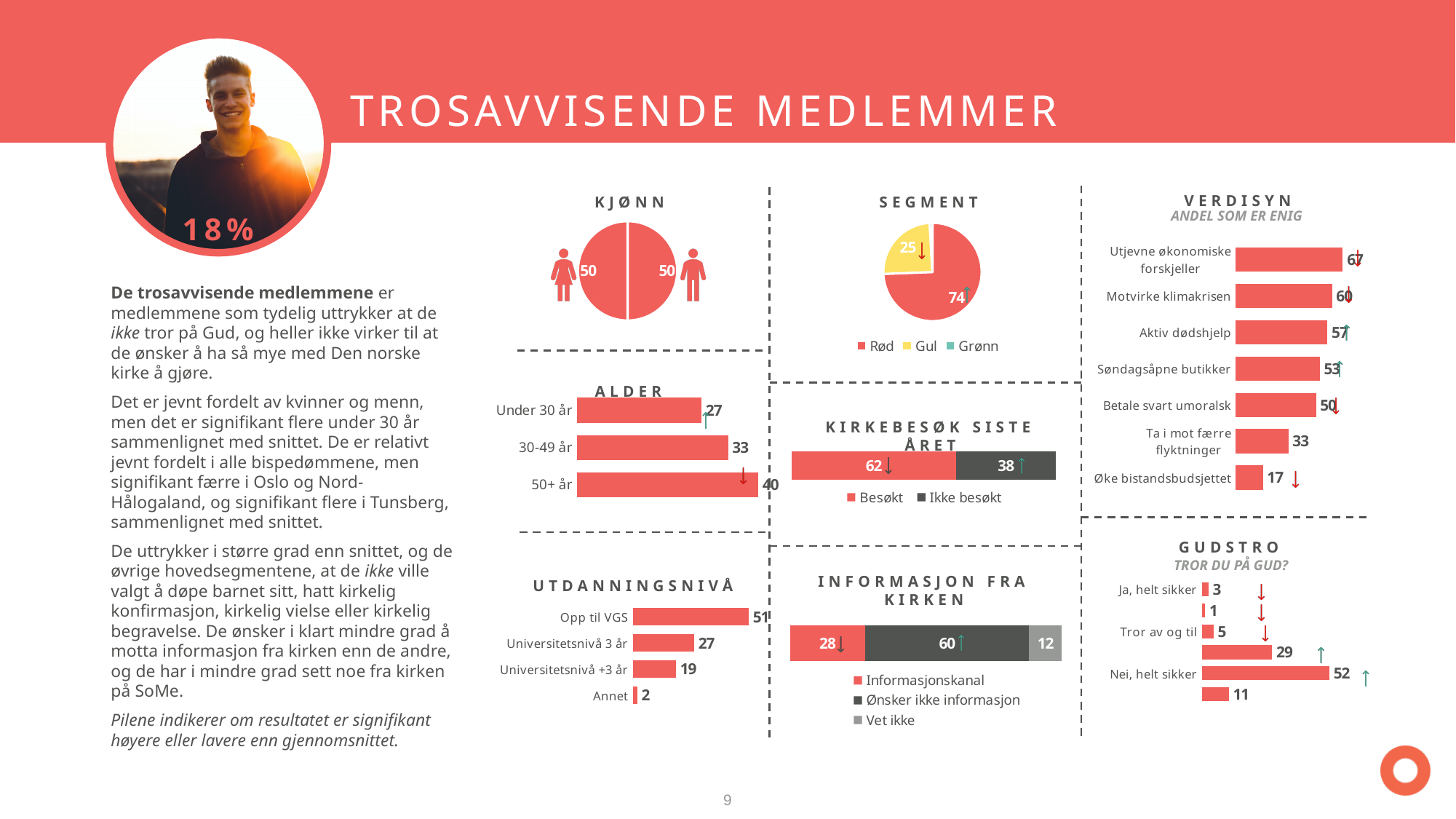
In the VERDISYN chart, which statement has the highest share agreeing? Utjevne økonomiske forskjeller In the KIRKEBESØK SISTE ÅRET chart, what is the value for Besøkt? 62 In the INFORMASJON FRA KIRKEN chart, which is larger: Informasjonskanal or Ønsker ikke informasjon? Ønsker ikke informasjon In the UTDANNINGSNIVÅ chart, what is the value for Universitetsnivå 3 år? 27 In the ALDER chart, which age group has the lowest value? Under 30 år In the VERDISYN chart, what is the value for Aktiv dødshjelp? 57 In the ALDER chart, what is the value for 50+ år? 40 In the UTDANNINGSNIVÅ chart, how many categories are shown? 4 What kind of chart is the KJØNN chart? Pie chart In the VERDISYN chart, what is the difference between Utjevne økonomiske forskjeller and Øke bistandsbudsjettet? 50 In the INFORMASJON FRA KIRKEN chart, how many series does the legend list? 3 In the SEGMENT chart, what is the value for Rød? 74